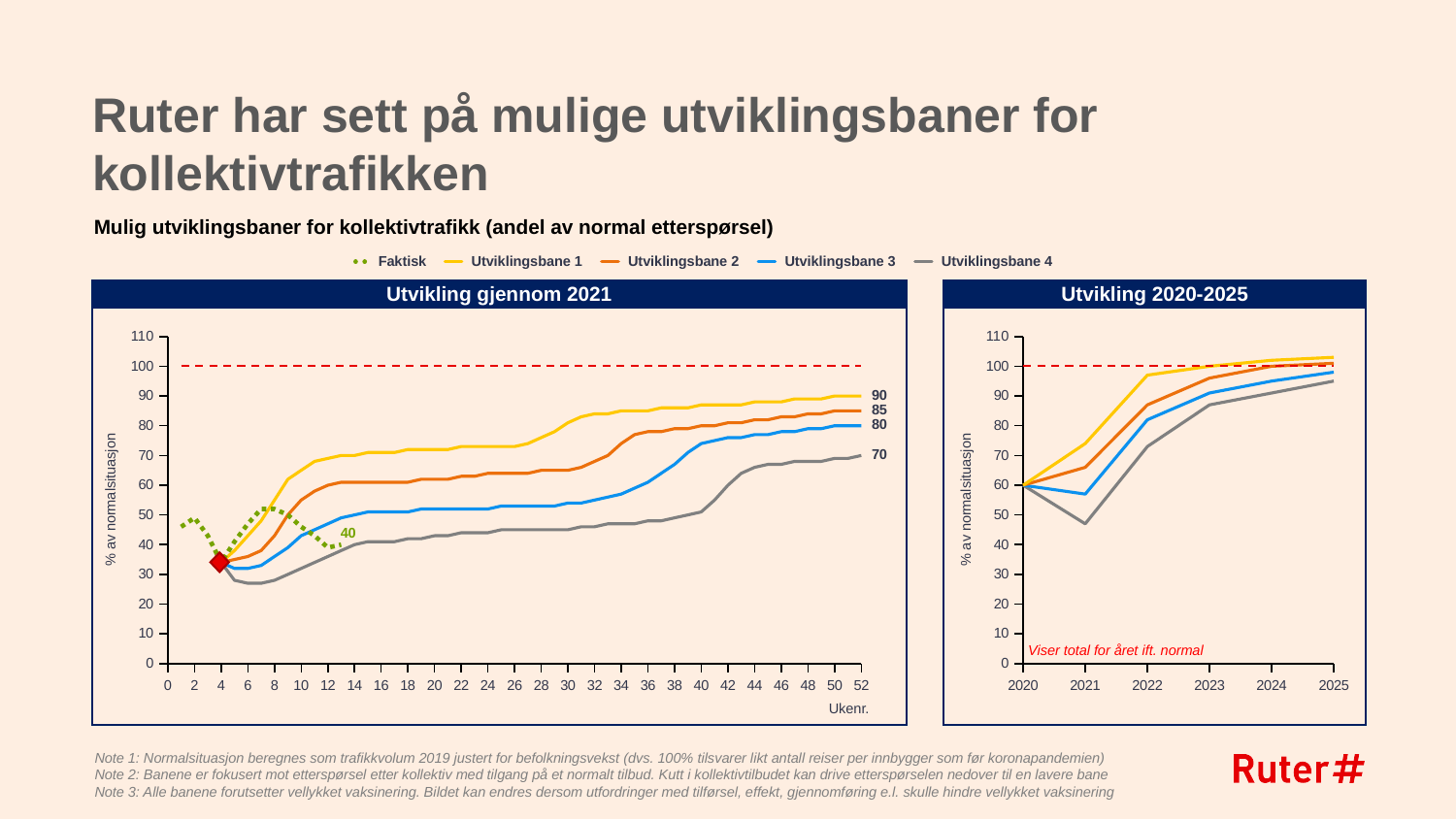
In the chart titled "Utvikling gjennom 2021", what value does Utviklingsbane 1 reach at week 52? 90 What kind of chart is "Utvikling 2020-2025"? Line chart In the chart titled "Utvikling gjennom 2021", which is larger at week 52: Utviklingsbane 2 or Utviklingsbane 3? Utviklingsbane 2 In the chart titled "Utvikling 2020-2025", is the value for Utviklingsbane 4 in 2021 greater or less than 50? less In the chart titled "Utvikling gjennom 2021", what is the difference between the week-52 values of Utviklingsbane 2 and Utviklingsbane 4? 15 In the chart titled "Utvikling gjennom 2021", what value does Utviklingsbane 3 reach at week 52? 80 In the chart titled "Utvikling gjennom 2021", which series ends lowest at week 52? Utviklingsbane 4 In the chart titled "Utvikling gjennom 2021", which series ends highest at week 52? Utviklingsbane 1 How many series does the legend list for the charts? 5 In the chart titled "Utvikling 2020-2025", do the values of Utviklingsbane 1 rise or fall from 2021 to 2025? rise In the chart titled "Utvikling gjennom 2021", what value does Utviklingsbane 4 reach at week 52? 70 In the chart titled "Utvikling 2020-2025", how many years are shown on the x axis? 6